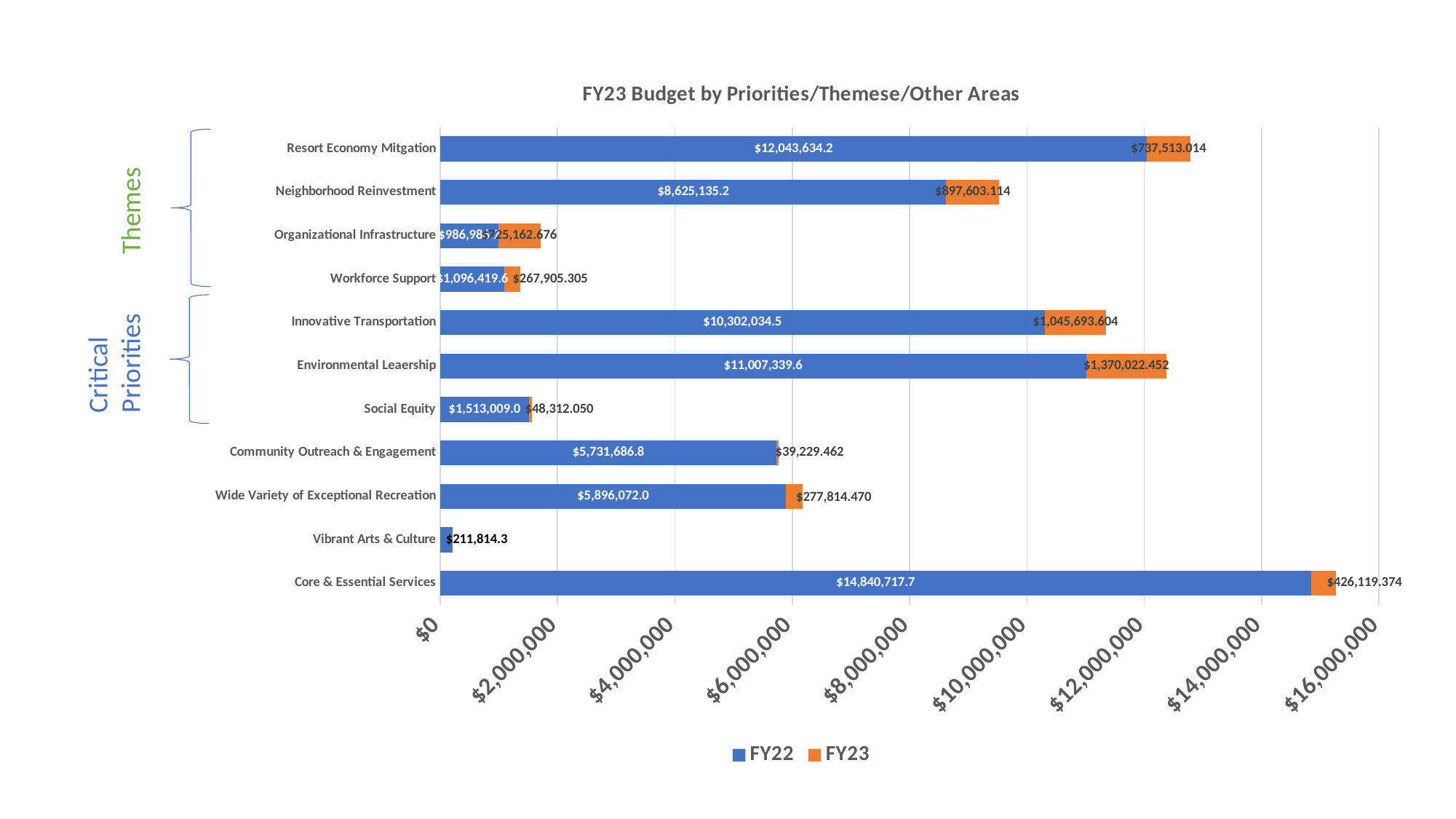
Is the FY22 value for Neighborhood Reinvestment greater or less than $8,000,000? greater Which category has the highest FY22 value? Core & Essential Services How many series does the legend list? 2 What type of chart is shown on the slide? Stacked bar chart Which has the larger FY22 value, Innovative Transportation or Environmental Leaership? Environmental Leaership What is the FY22 value for Core & Essential Services? $14,840,717.7 How many categories are shown on the chart? 11 What is the difference between the FY22 values for Wide Variety of Exceptional Recreation and Community Outreach & Engagement? $164,385.2 Which category has the highest FY23 value? Environmental Leaership Which category has the lowest FY22 value? Vibrant Arts & Culture What is the FY23 value for Environmental Leaership? $1,370,022.452 What is the FY23 value for Social Equity? $48,312.050